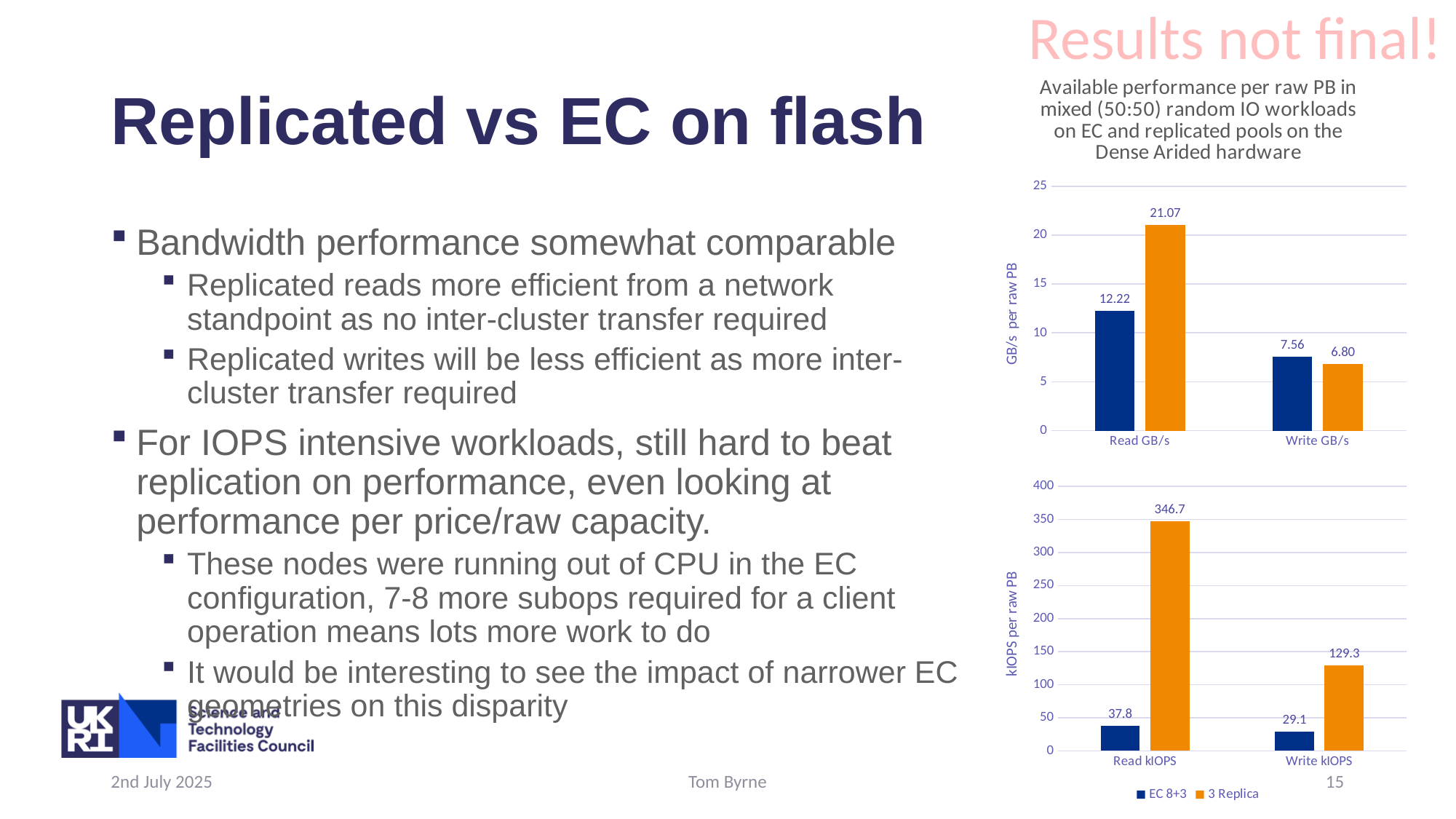
In the top chart (GB/s per raw PB), what is the difference between the 3 Replica and EC 8+3 Read GB/s values? 8.85 In the top chart (GB/s per raw PB), what is the Write GB/s value for EC 8+3? 7.56 In the bottom chart (kIOPS per raw PB), which bar has the highest value? 3 Replica, Read kIOPS In the top chart (GB/s per raw PB), which series has the higher Write GB/s value? EC 8+3 In the bottom chart (kIOPS per raw PB), what is the Write kIOPS value for EC 8+3? 29.1 What type of chart is the bottom chart (kIOPS per raw PB)? Bar chart Which colour represents the 3 Replica series in the charts? Orange In the bottom chart (kIOPS per raw PB), what is the difference between the 3 Replica and EC 8+3 Write kIOPS values? 100.2 In the bottom chart (kIOPS per raw PB), what is the Read kIOPS value for 3 Replica? 346.7 In the top chart (GB/s per raw PB), what is the Read GB/s value for 3 Replica? 21.07 In the bottom chart (kIOPS per raw PB), which bar has the lowest value? EC 8+3, Write kIOPS How many series does the legend list for the charts? 2